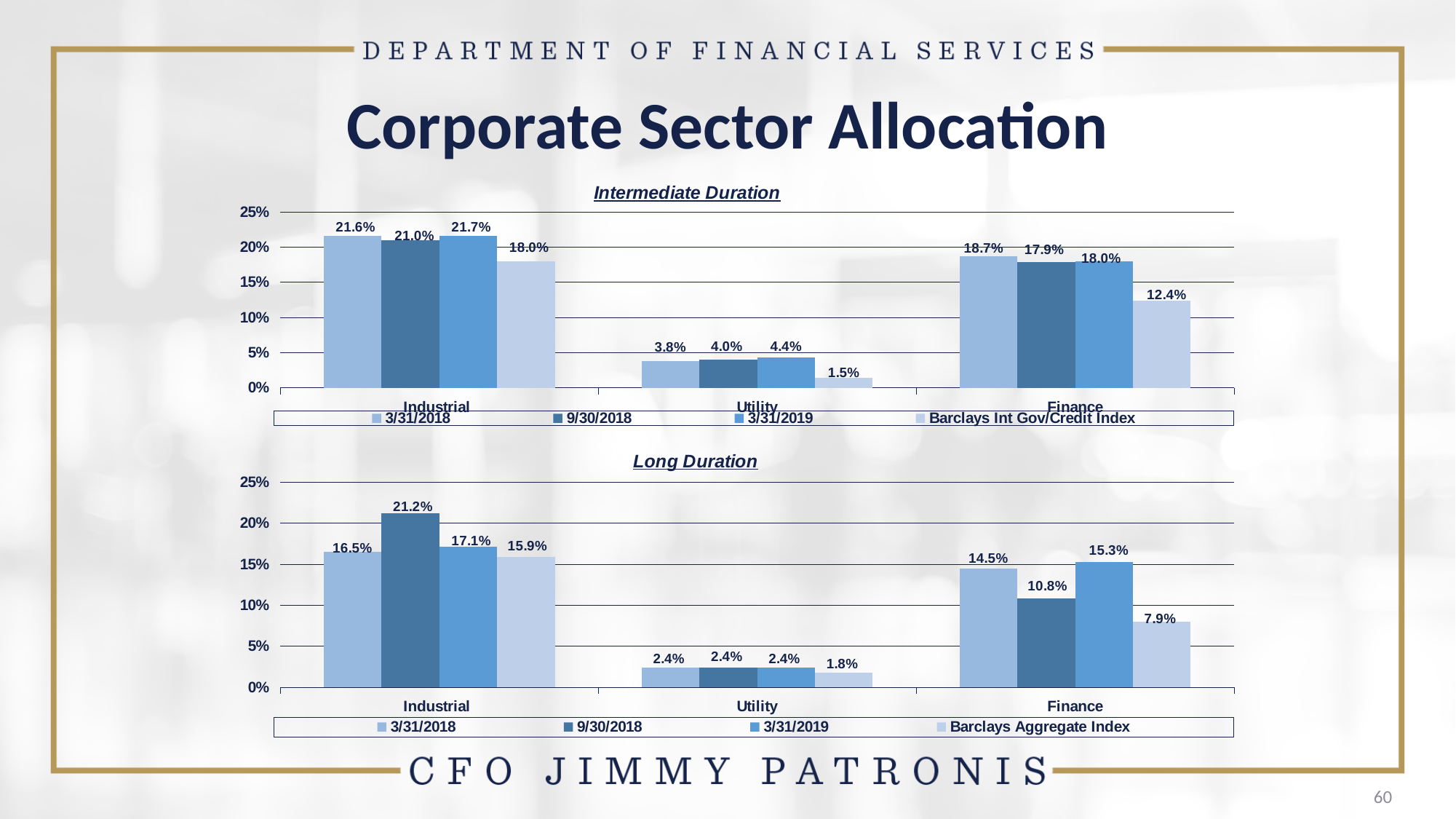
In the Intermediate Duration chart, what is the value for Industrial on 3/31/2019? 21.7% In the Intermediate Duration chart, which category has the lowest value for 3/31/2018? Utility In the Long Duration chart, which category has the highest value for 9/30/2018? Industrial In the Intermediate Duration chart, what is the difference between the Finance values for 3/31/2018 and the Barclays Int Gov/Credit Index? 6.3% In the Long Duration chart, what is the name of the fourth legend entry? Barclays Aggregate Index In the Intermediate Duration chart, what is the Barclays Int Gov/Credit Index value for Utility? 1.5% In the Long Duration chart, what is the value for Finance on 9/30/2018? 10.8% How many series does the legend of the Long Duration chart list? 4 In the Long Duration chart, is the Industrial value for 9/30/2018 greater or less than 20%? greater In the Long Duration chart, which is larger for Finance: the 3/31/2018 value or the 3/31/2019 value? 3/31/2019 How many categories are shown on the x axis of the Intermediate Duration chart? 3 What kind of chart is the Long Duration chart? Bar chart